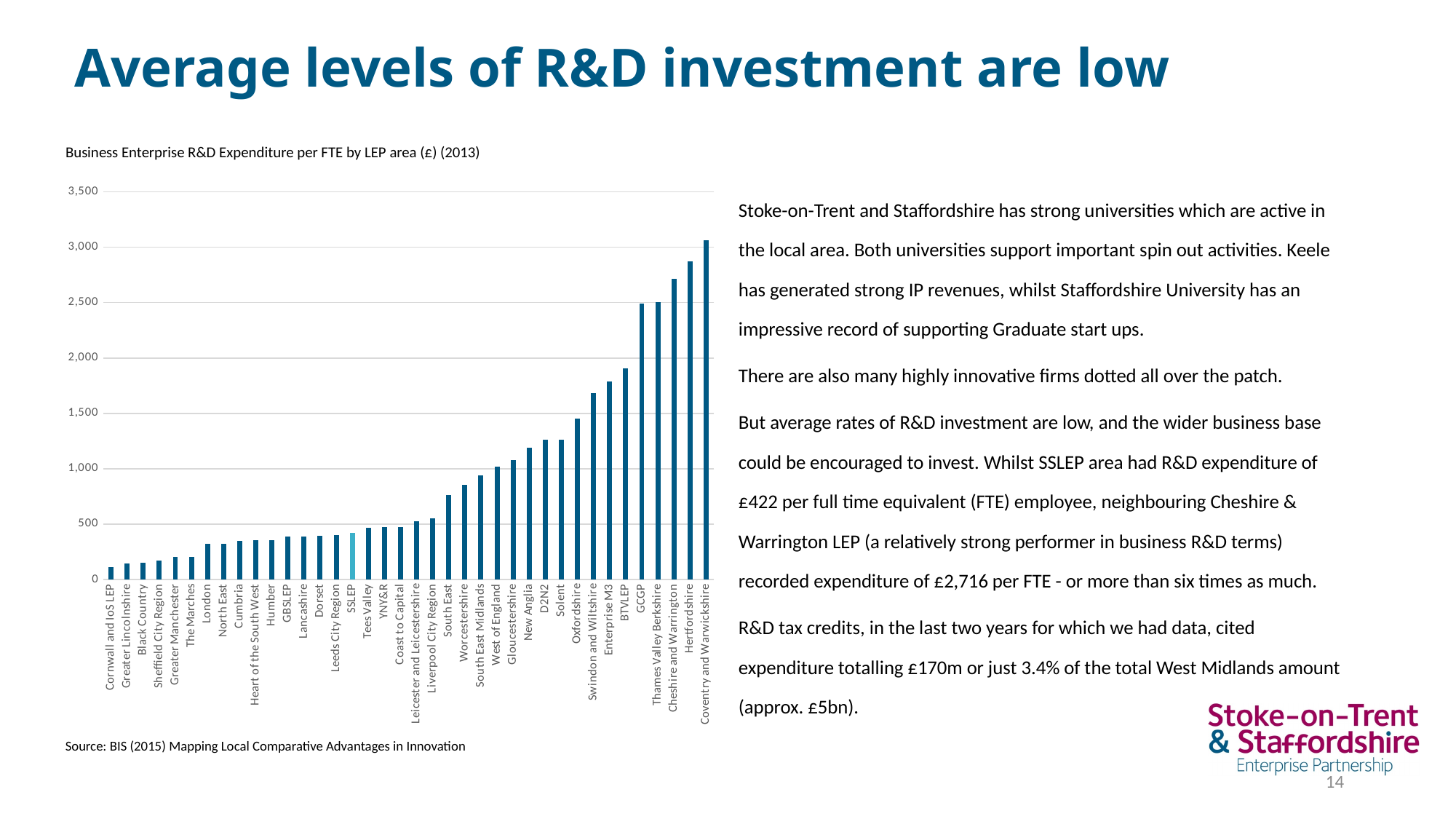
What kind of chart is shown on the slide? bar chart Is the value for Hertfordshire greater or less than 2,500? greater Is the value for Swindon and Wiltshire greater or less than 1,500? greater What is the title of the chart? Business Enterprise R&D Expenditure per FTE by LEP area (£) (2013) Which LEP area has the highest R&D expenditure per FTE in the chart? Coventry and Warwickshire Which has the larger value, Hertfordshire or Thames Valley Berkshire? Hertfordshire Which bar in the chart is highlighted in a lighter blue colour than the others? SSLEP Is the value for London greater or less than 500? less Which LEP area has the lowest R&D expenditure per FTE in the chart? Cornwall and IoS LEP According to the slide, what was the R&D expenditure per FTE for the SSLEP area? £422 Do the bar values rise or fall moving from left to right along the x axis? rise How many LEP areas are plotted in the chart? 38